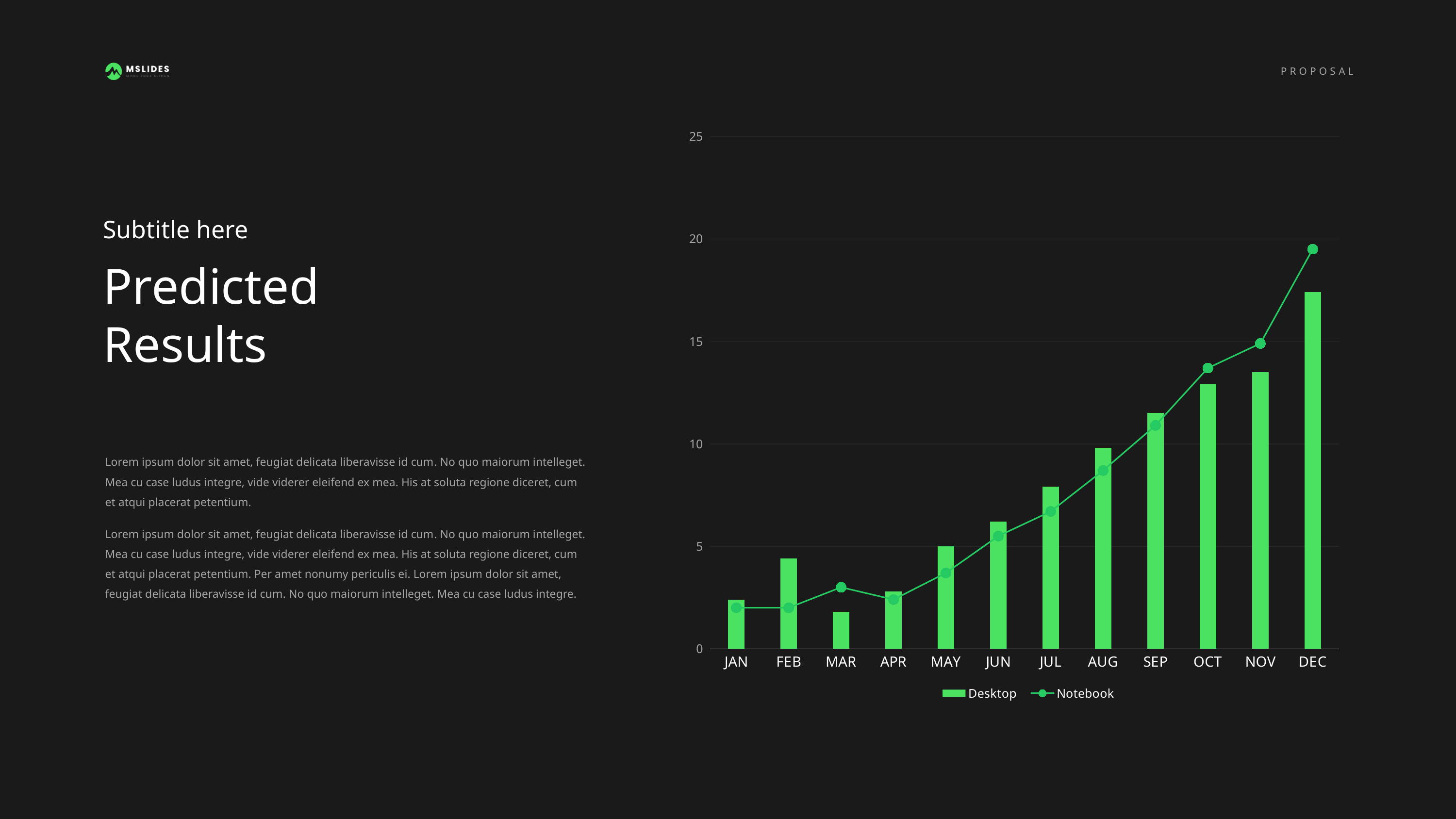
Which is larger in DEC, the Desktop value or the Notebook value? Notebook Which month has the highest Notebook value? DEC Which month has the lowest Desktop bar? MAR How many months are shown on the x axis? 12 Which month has the highest Desktop bar? DEC Which is larger in FEB, the Desktop value or the Notebook value? Desktop Is the Desktop value for DEC greater or less than 15? greater Is the Notebook value for NOV greater or less than 10? greater Do the Desktop values generally rise or fall from JAN to DEC? rise How many series does the legend list? 2 Is the Notebook value for MAY greater or less than 5? less